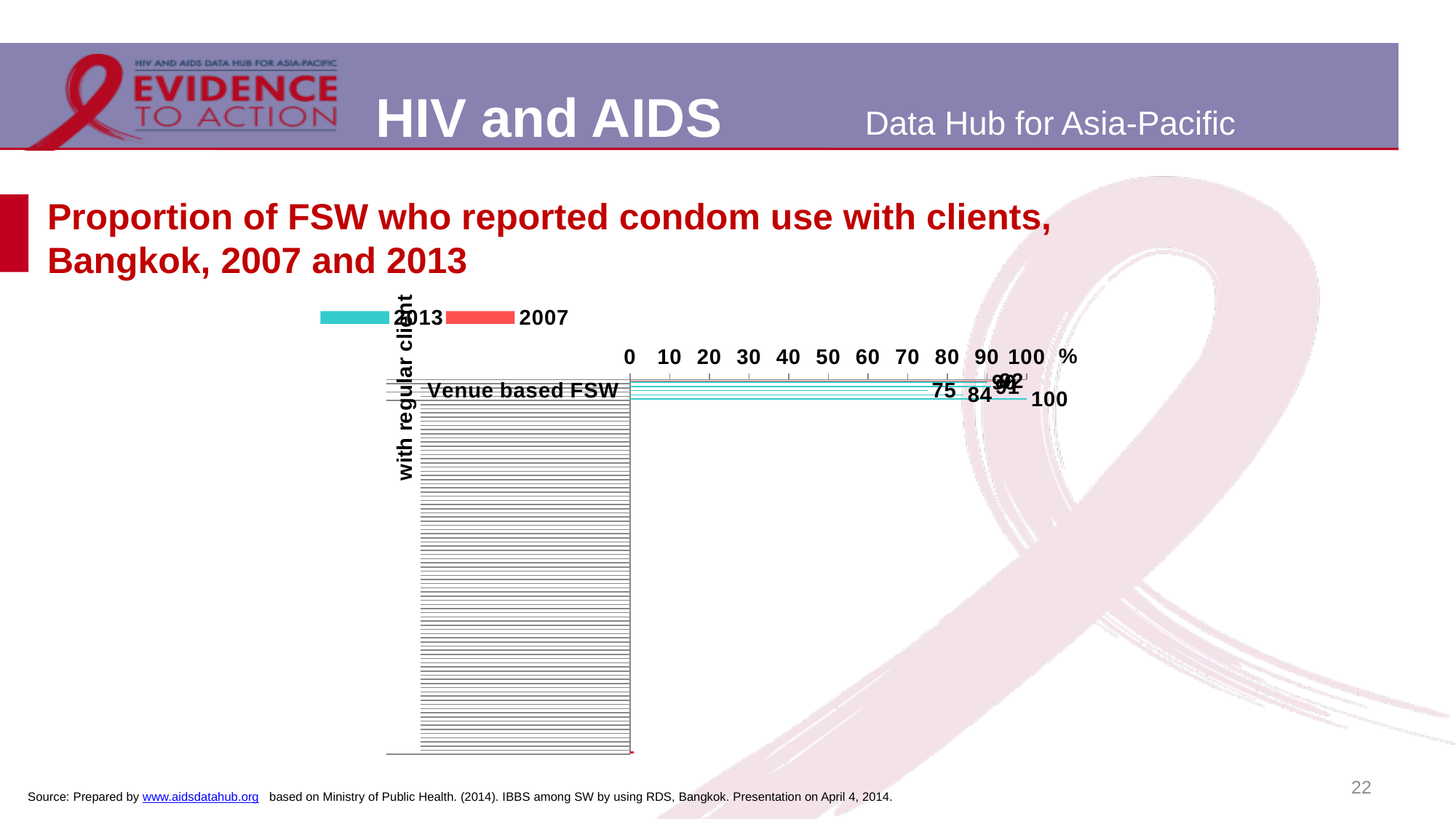
What unit is shown at the end of the chart's horizontal axis? % What kind of chart is shown on the slide? bar chart Which colour represents the 2007 series in the legend? red Which category label is readable on the chart's vertical axis? Venue based FSW What is the highest tick value shown on the chart's horizontal axis? 100 How many series does the chart legend list? 2 Which two years are listed in the chart legend? 2013 and 2007